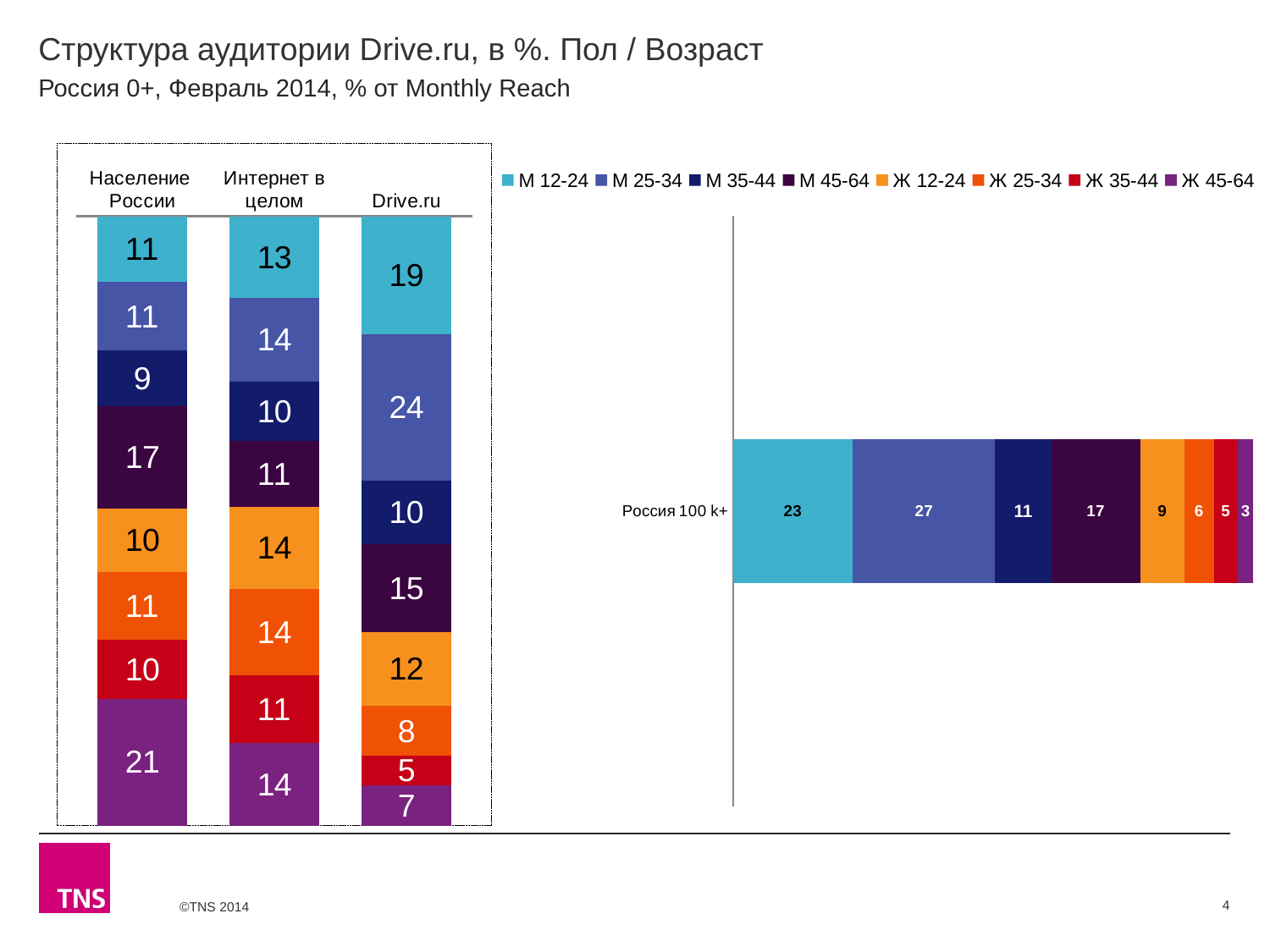
In the left chart, which is larger: the Ж 12-24 value for Интернет в целом or for Drive.ru? Интернет в целом In the left chart, what is the value of the М 25-34 segment for Drive.ru? 24 In the right chart (Россия 100 k+), which segment is the smallest? Ж 45-64 In the right chart (Россия 100 k+), what is the value of the М 25-34 segment? 27 In the left chart, what is the value of the Ж 45-64 segment for Население России? 21 How many series does the legend list? 8 In the left chart, which segment is the smallest in the Drive.ru bar? Ж 35-44 How many bars are shown in the left chart? 3 In the left chart, which segment is the largest in the Drive.ru bar? М 25-34 In the left chart, what is the value of the М 35-44 segment for Интернет в целом? 10 In the left chart, what is the difference between the М 12-24 values for Drive.ru and Население России? 8 What type of chart is the right chart (Россия 100 k+)? Stacked bar chart